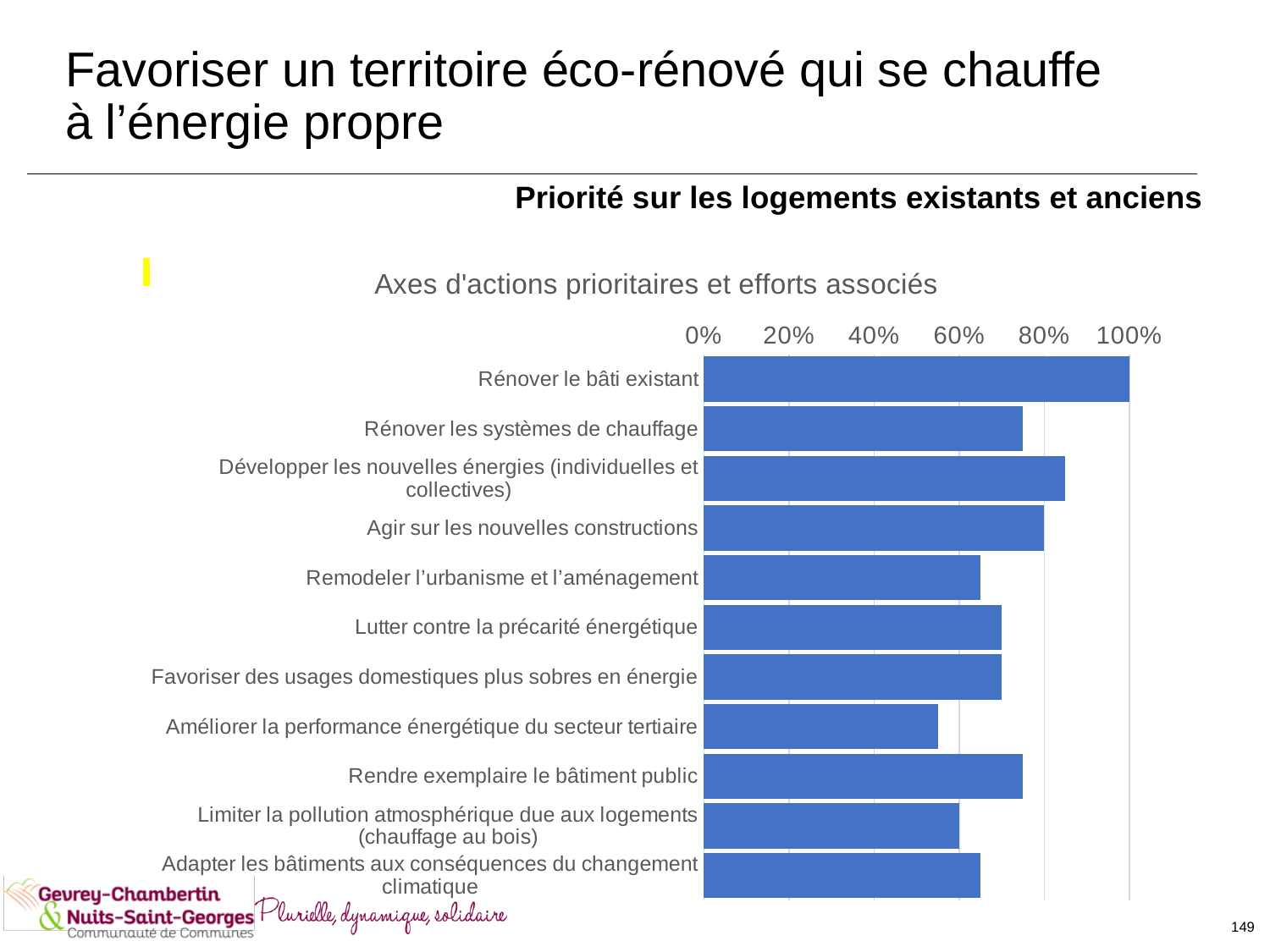
How many categories (action axes) are plotted in the chart? 11 What kind of chart is shown on the slide? Bar chart What is the title of the chart? Axes d'actions prioritaires et efforts associés What is the value for "Rénover le bâti existant"? 100% Which category has the lowest value in the chart? Améliorer la performance énergétique du secteur tertiaire Is the value for "Améliorer la performance énergétique du secteur tertiaire" greater or less than 60%? less Is the value for "Limiter la pollution atmosphérique due aux logements (chauffage au bois)" greater or less than 80%? less Which has the larger value: "Agir sur les nouvelles constructions" or "Améliorer la performance énergétique du secteur tertiaire"? Agir sur les nouvelles constructions Which has the larger value: "Développer les nouvelles énergies (individuelles et collectives)" or "Remodeler l'urbanisme et l'aménagement"? Développer les nouvelles énergies (individuelles et collectives) Is the value for "Développer les nouvelles énergies (individuelles et collectives)" greater or less than 80%? greater Which category has the highest value in the chart? Rénover le bâti existant